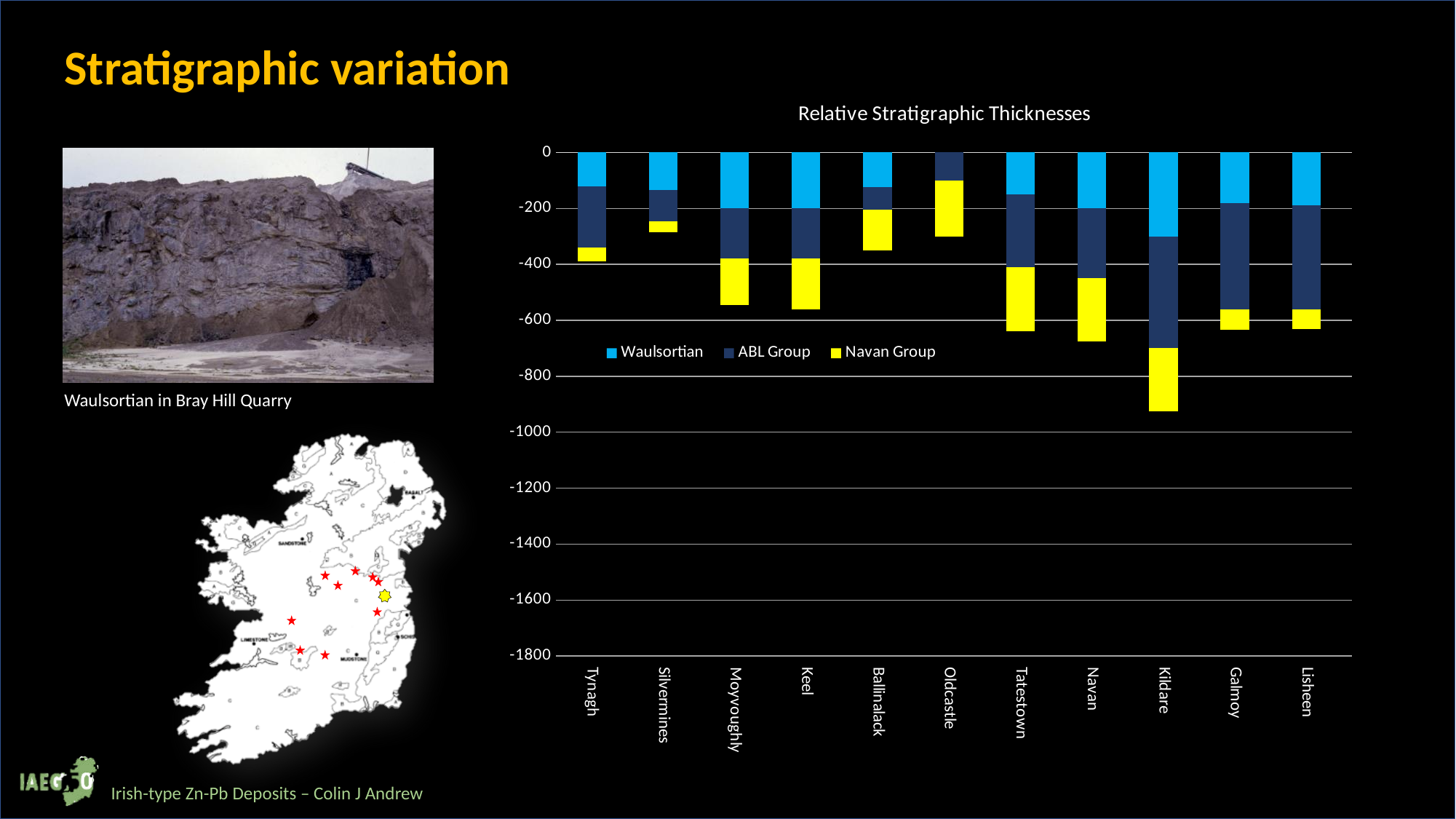
Does the bottom of the Oldcastle bar lie above or below the -400 gridline? above How many series does the chart legend list? 3 Which category has the largest Waulsortian segment? Kildare Which category has no Waulsortian segment in its bar? Oldcastle Which category's stacked bar extends furthest down the axis (the greatest total thickness)? Kildare How many deposit categories are plotted along the x axis of the chart? 11 What colour represents the Navan Group series in the chart? Yellow Which bar extends further down the axis, Kildare or Tynagh? Kildare Which bar extends further down the axis, Moyvoughly or Silvermines? Moyvoughly Does the bottom of the Navan bar lie above or below the -600 gridline? below What kind of chart is shown under the title 'Relative Stratigraphic Thicknesses'? Stacked bar chart Does the bottom of the Kildare bar lie above or below the -800 gridline? below